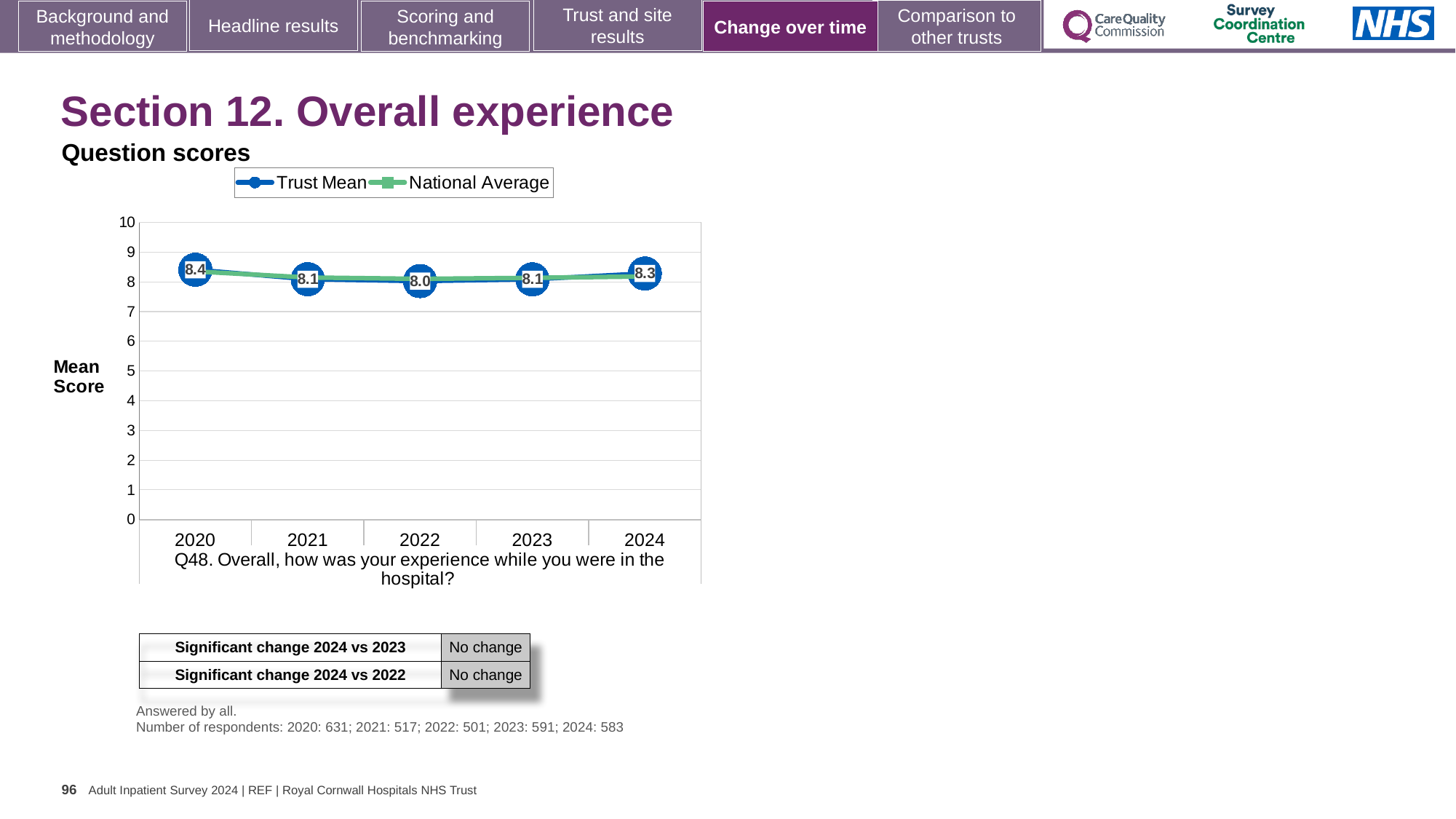
Does the Trust Mean score rise or fall from 2020 to 2022? Fall How many series does the legend list? 2 What is the Trust Mean score for 2020? 8.4 Is the National Average value for 2022 greater or less than 7? greater In which year is the Trust Mean score highest? 2020 What is the difference between the Trust Mean scores for 2020 and 2022? 0.4 What kind of chart is shown? Line chart Is the Trust Mean score higher in 2024 or in 2023? 2024 In which year is the Trust Mean score lowest? 2022 How many years are plotted on the x axis? 5 What is the Trust Mean score for 2024? 8.3 What is the Trust Mean score for 2022? 8.0